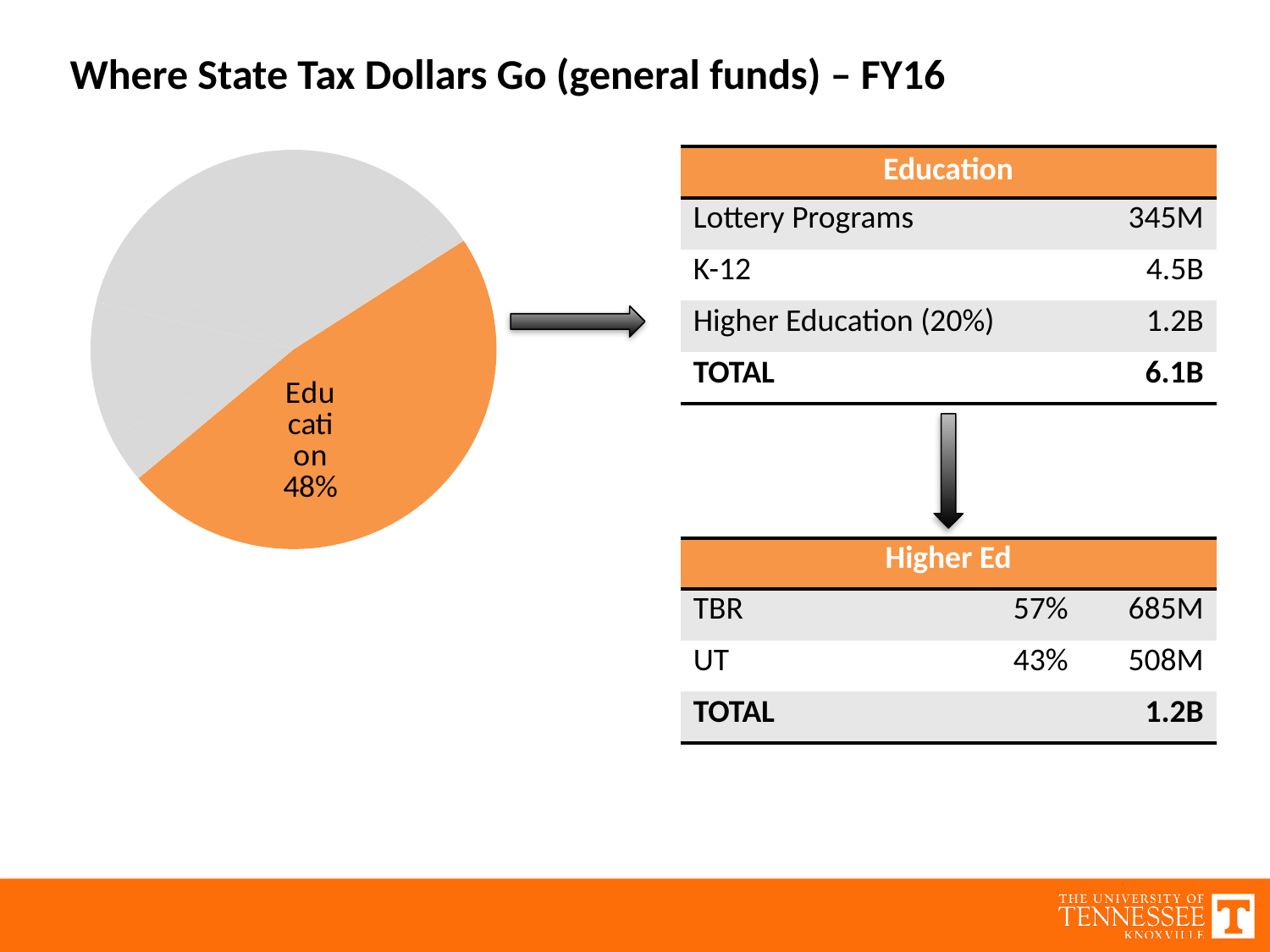
Which slice of the pie is larger, the orange Education slice or the gray unlabeled slice? the gray unlabeled slice What is the title of the slide containing the pie chart? Where State Tax Dollars Go (general funds) – FY16 Which category is labelled on the pie chart? Education Is the Education slice of the pie greater or less than 50%? less What colour is the Education slice in the pie chart? orange What share of the pie does the Education slice represent? 48% What kind of chart is shown on the slide? pie chart